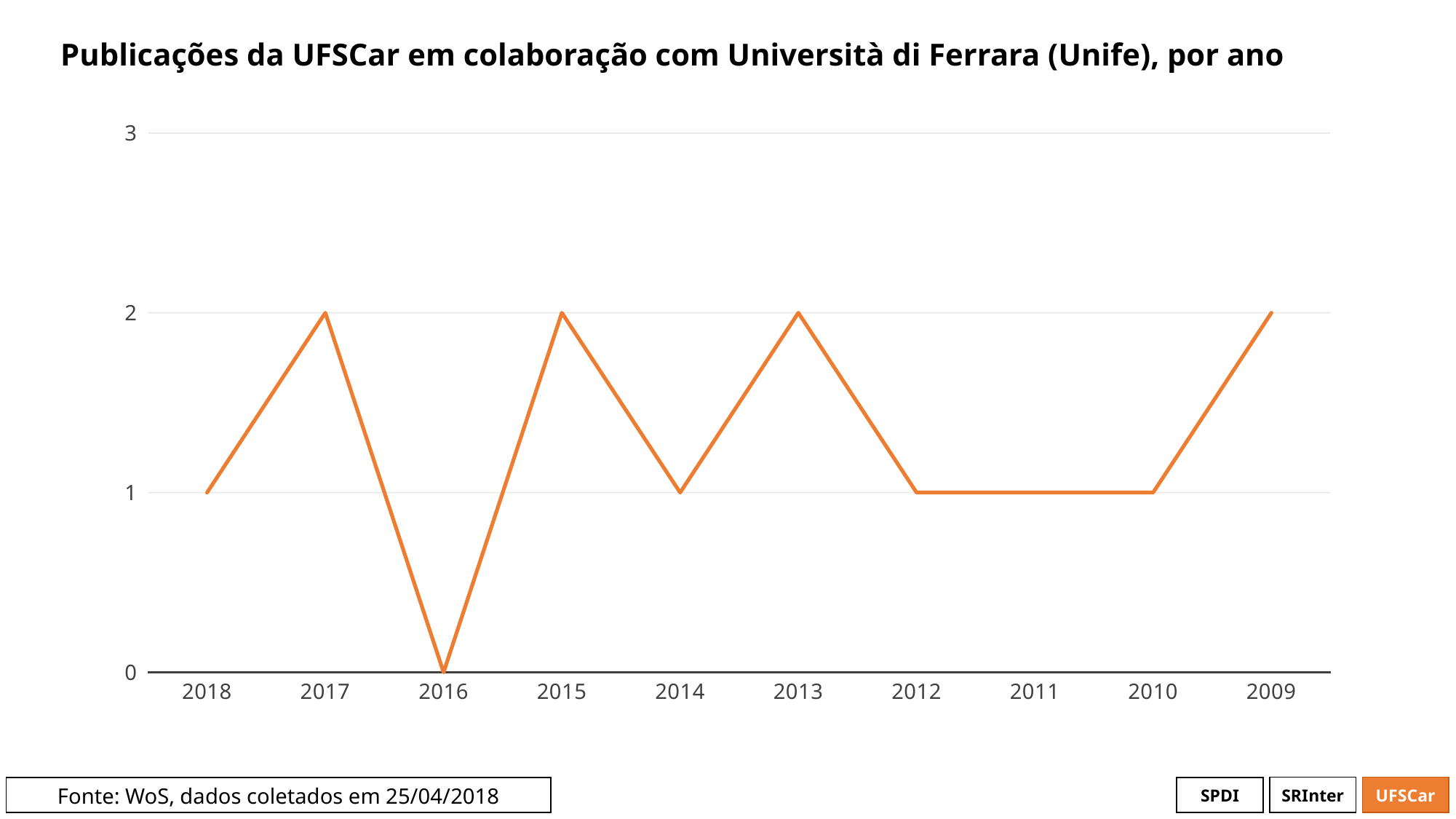
What is the value for 2018? 1 What type of chart is shown on the slide? line chart What is the value for 2016? 0 Does the value rise or fall from 2010 to 2009? rise Which is larger, the value for 2015 or the value for 2014? 2015 What is the difference between the values for 2017 and 2016? 2 Which year has the lowest value? 2016 What is the value for 2017? 2 How many years are plotted on the x axis? 10 What colour is the line in the chart? orange What is the title of the chart? Publicações da UFSCar em colaboração com Università di Ferrara (Unife), por ano What is the value for 2011? 1